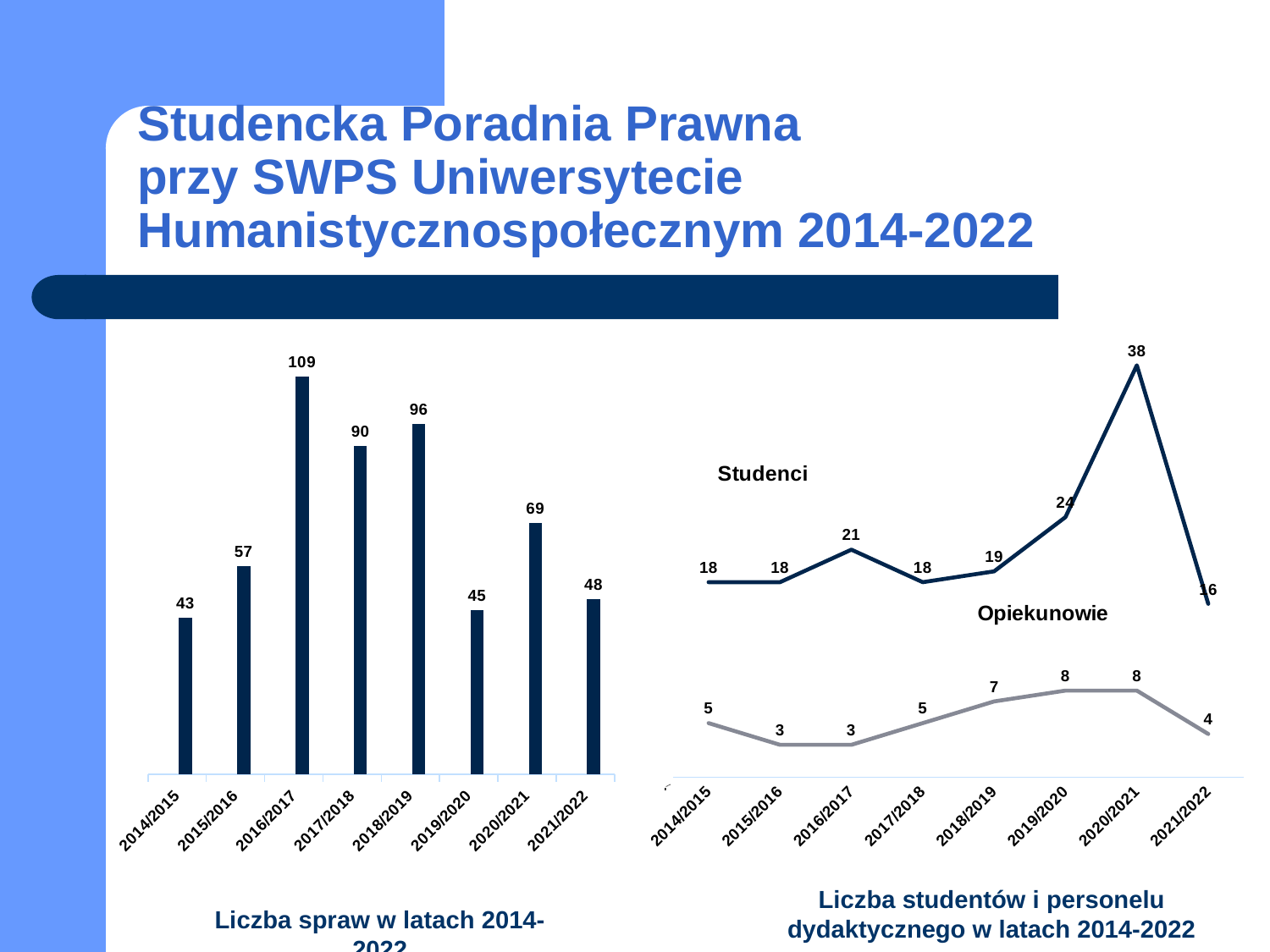
In the left chart (Liczba spraw w latach 2014-2022), what is the difference between the values for 2018/2019 and 2019/2020? 51 In the left chart (Liczba spraw w latach 2014-2022), what is the value for 2016/2017? 109 What kind of chart is the left chart (Liczba spraw w latach 2014-2022)? bar chart In the right chart (Liczba studentów i personelu dydaktycznego), what is the Opiekunowie value for 2018/2019? 7 In the right chart (Liczba studentów i personelu dydaktycznego), what is the Studenci value for 2020/2021? 38 What kind of chart is the right chart (Liczba studentów i personelu dydaktycznego)? line chart In the right chart (Liczba studentów i personelu dydaktycznego), in which year does the Studenci series reach its highest value? 2020/2021 In the left chart (Liczba spraw w latach 2014-2022), which year has the lowest value? 2014/2015 In the left chart (Liczba spraw w latach 2014-2022), how many years are shown on the x axis? 8 In the right chart (Liczba studentów i personelu dydaktycznego), what is the difference between the Studenci and Opiekunowie values for 2016/2017? 18 In the left chart (Liczba spraw w latach 2014-2022), which year has the highest value? 2016/2017 In the left chart (Liczba spraw w latach 2014-2022), which is larger, the value for 2015/2016 or the value for 2020/2021? 2020/2021